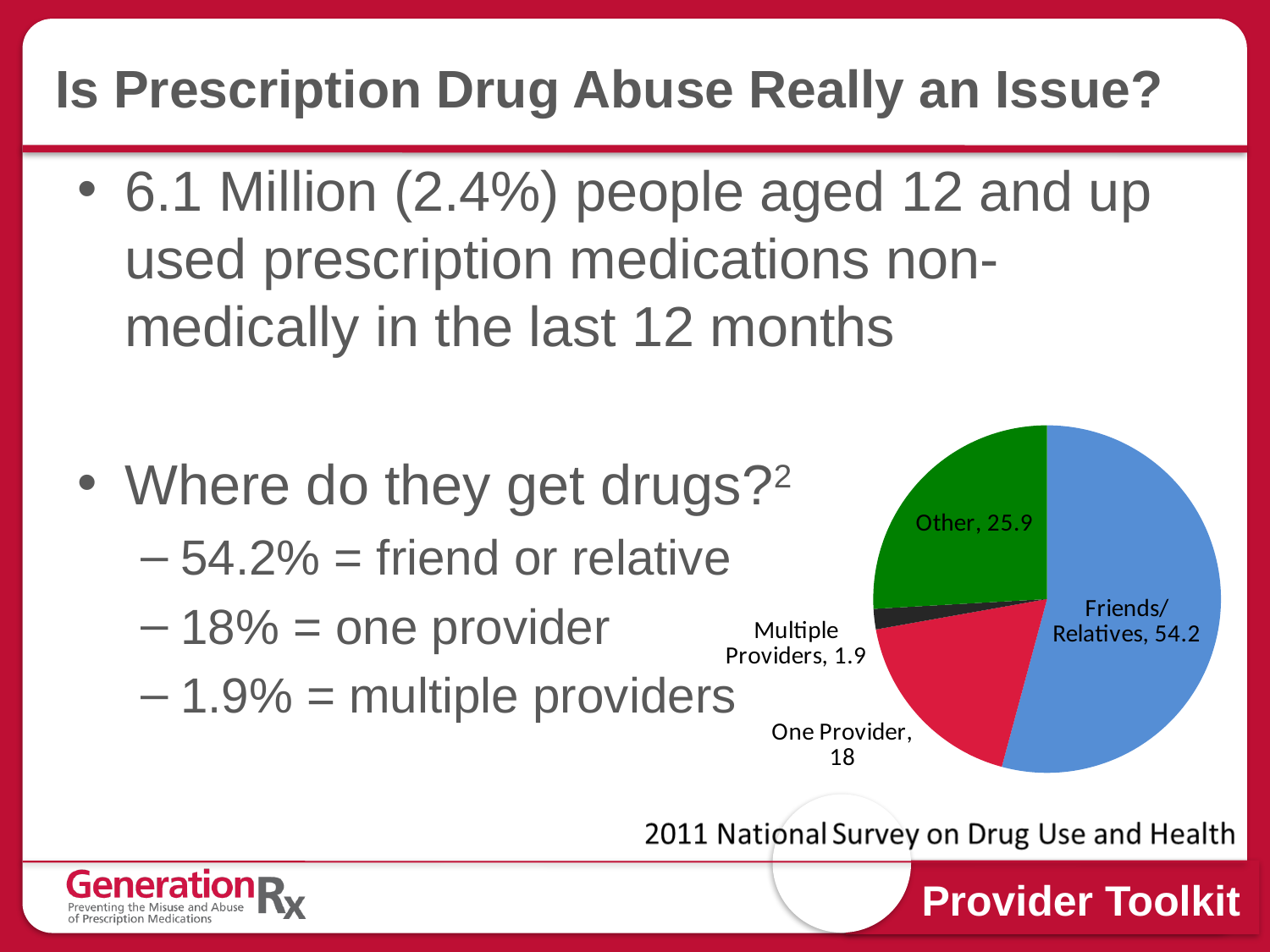
What is the value shown for the Multiple Providers slice of the pie chart? 1.9 Which slice of the pie chart is the smallest? Multiple Providers What is the value shown for the One Provider slice of the pie chart? 18 Which slice of the pie chart is the largest? Friends/Relatives What is the value shown for the Friends/Relatives slice of the pie chart? 54.2 What is the difference between the One Provider value and the Multiple Providers value in the pie chart? 16.1 How many slices does the pie chart have? 4 What is the value shown for the Other slice of the pie chart? 25.9 What kind of chart is shown on the slide? pie chart Which is larger in the pie chart, One Provider or Other? Other What colour is the Friends/Relatives slice of the pie chart? blue What is the difference between the Friends/Relatives value and the Other value in the pie chart? 28.3